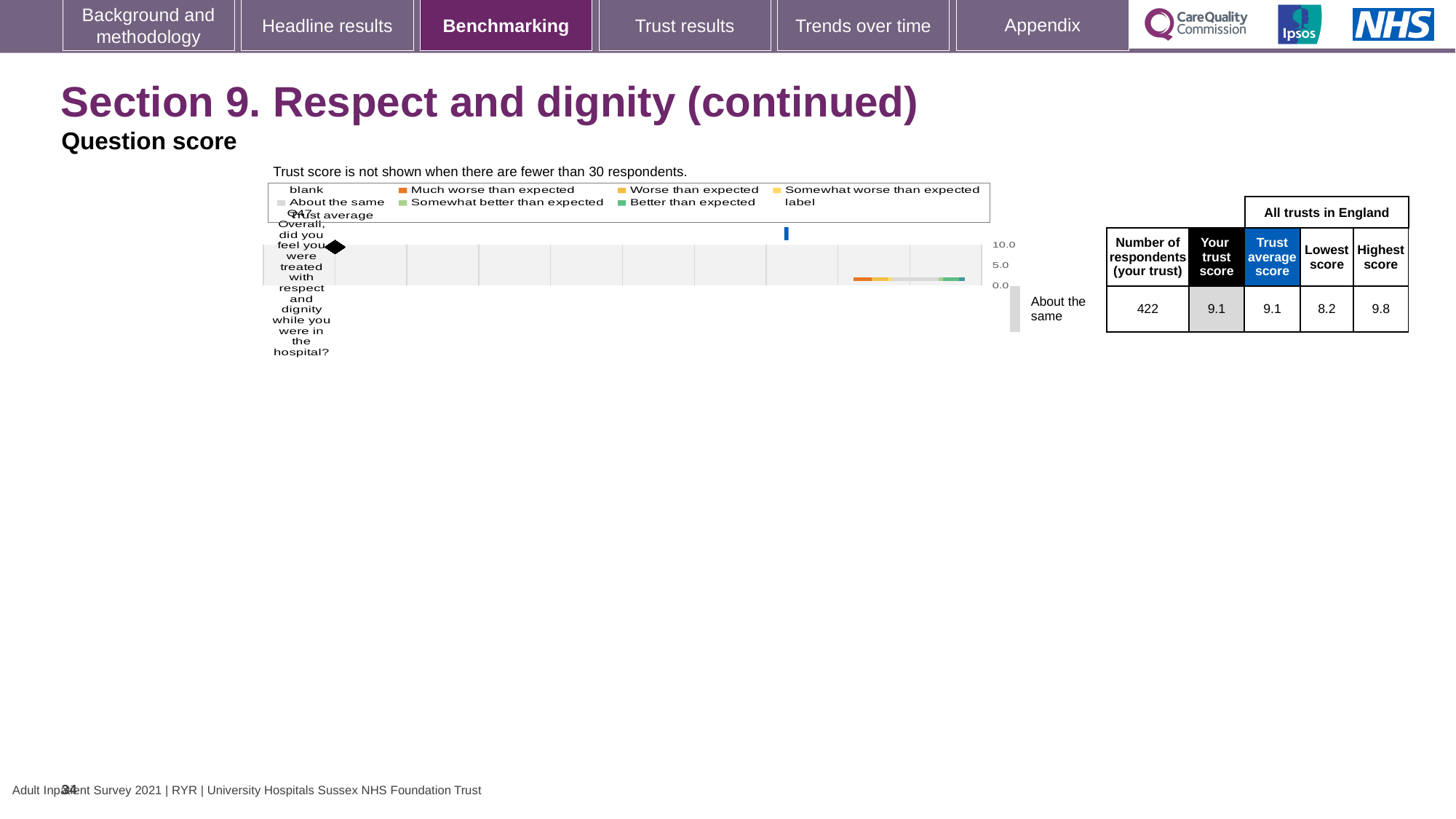
What is the highest score across all trusts in England for Q47? 9.8 How many entries does the chart legend list? 9 What is the difference between the highest score and the lowest score for Q47 in the table? 1.6 What is the benchmark rating shown for Q47 next to the chart? About the same What kind of chart is shown on the slide? bar chart What is the trust average score for Q47 shown in the table beside the chart? 9.1 Which question number is plotted on the chart? Q47 Is the trust average marker for Q47 greater or less than 5.0 on the axis? greater What is the highest value shown on the chart's axis? 10.0 What is the lowest score across all trusts in England for Q47? 8.2 How many questions (categories) are plotted on the chart? 1 What is the trust score for Q47 shown in the table beside the chart? 9.1